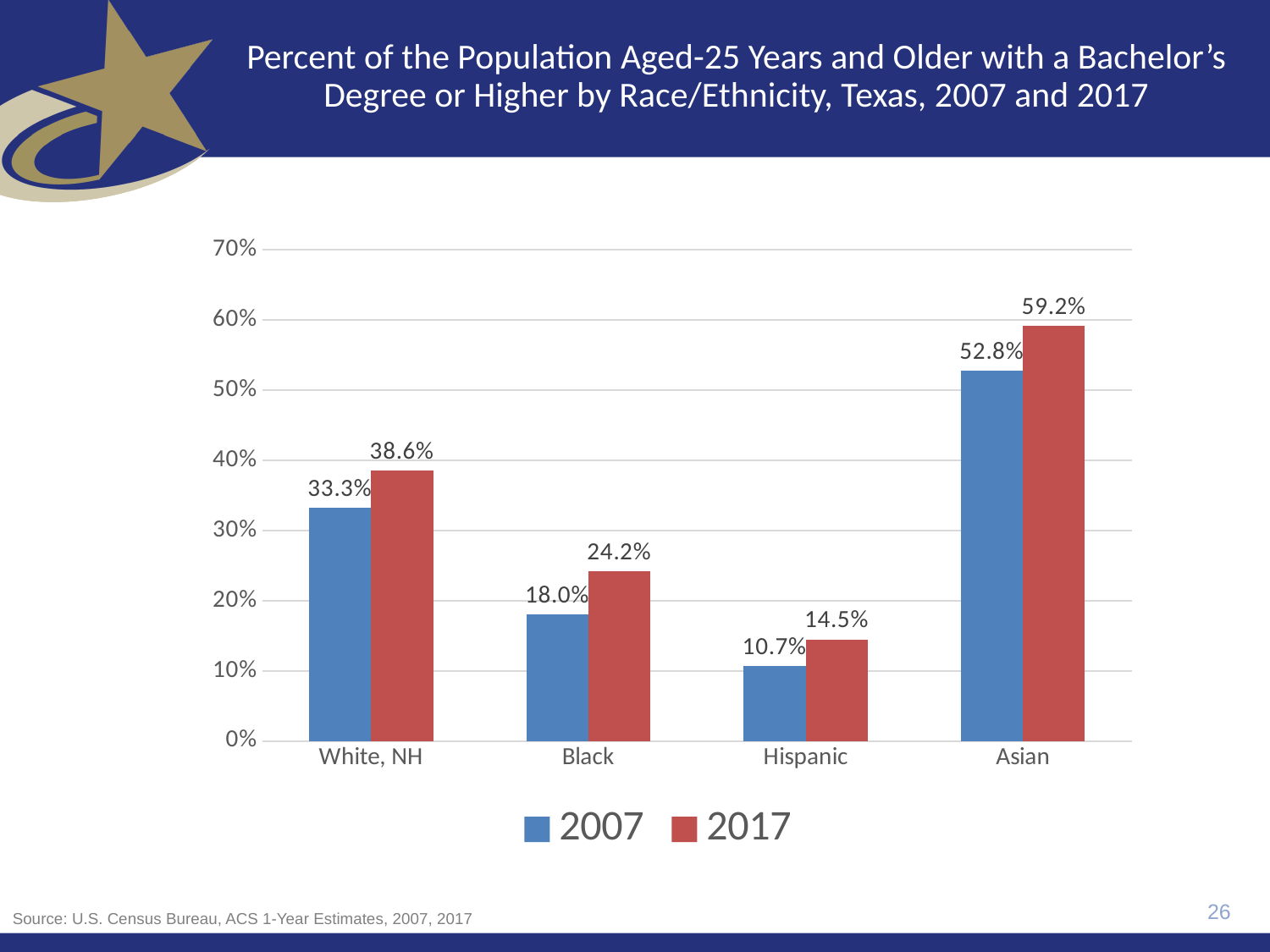
What is the difference between the 2017 and 2007 values for Black? 6.2% Which race/ethnicity group has the highest value in 2017? Asian What kind of chart is shown on the slide? Bar chart Which is larger: the 2007 value for Asian or the 2017 value for White, NH? 2007 value for Asian Which race/ethnicity group has the lowest value in 2007? Hispanic What is the difference between the 2017 and 2007 values for White, NH? 5.3% Which colour represents the 2017 series in the legend? Red What is the value for Black in 2017? 24.2% What is the value for Asian in 2017? 59.2% How many series does the legend list? 2 How many race/ethnicity categories are shown on the x axis? 4 What is the value for Hispanic in 2007? 10.7%